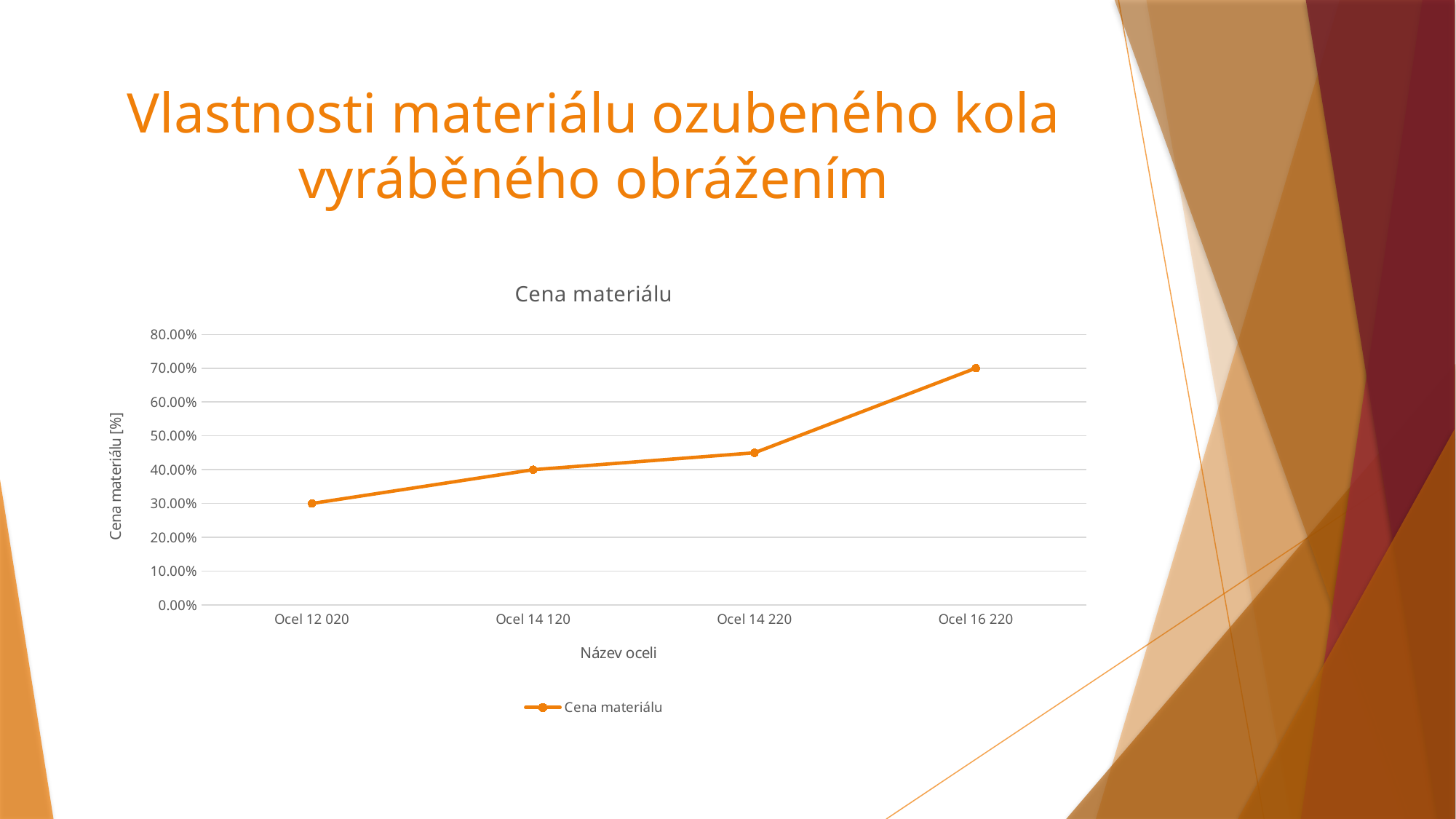
How many steel types are plotted on the x axis? 4 What is the value for Ocel 14 120? 40.00% Which steel type has the lowest value? Ocel 12 020 What is the title of the chart? Cena materiálu Which is larger, the value for Ocel 14 220 or the value for Ocel 16 220? Ocel 16 220 Is the value for Ocel 14 220 greater or less than 40.00%? greater What is the value for Ocel 12 020? 30.00% What is the value for Ocel 16 220? 70.00% Do the values rise or fall from Ocel 12 020 to Ocel 16 220? rise How many series does the legend list? 1 What kind of chart is shown on the slide? line chart Which steel type has the highest value? Ocel 16 220